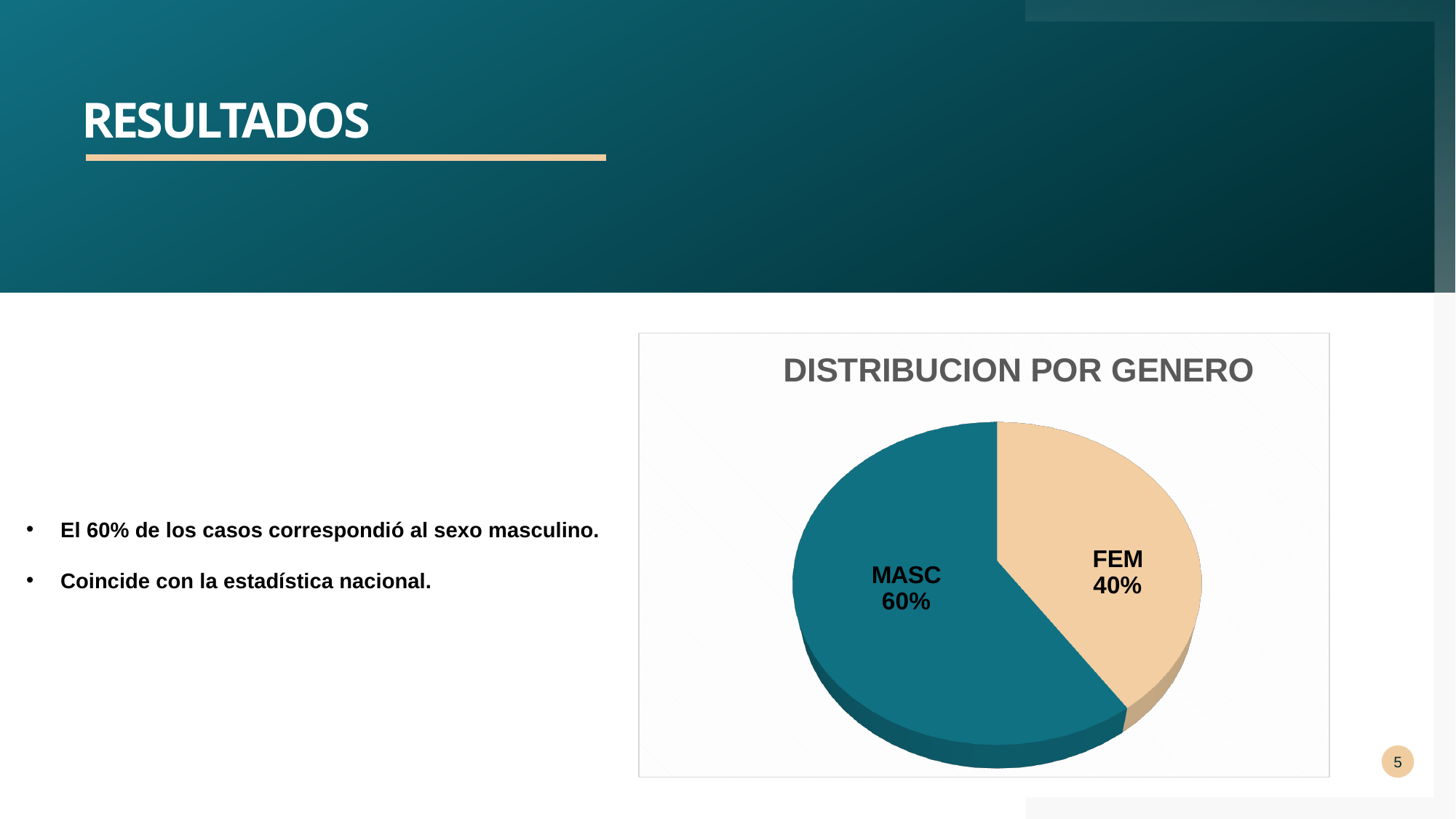
Which slice is larger, MASC or FEM? MASC What is the difference in percentage points between the MASC and FEM slices? 20% What colour is the MASC slice of the pie? Teal How many slices does the pie chart have? 2 Is the share for FEM greater or less than 50%? less What is the title of the chart? DISTRIBUCION POR GENERO What share of the pie does FEM represent? 40% Which category has the smallest slice of the pie? FEM What share of the pie does MASC represent? 60% Which category has the largest slice of the pie? MASC What kind of chart is shown on the slide? Pie chart